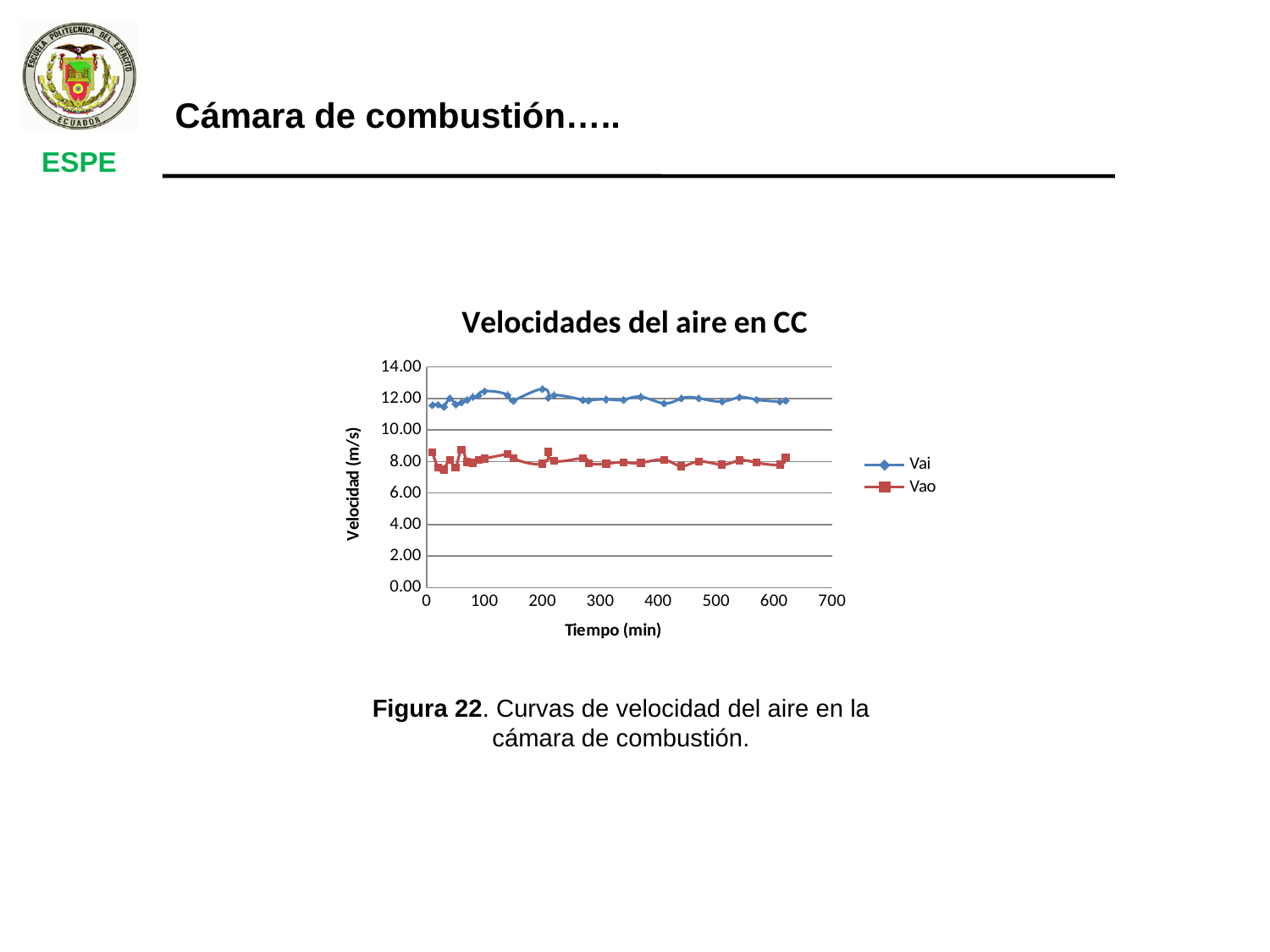
Which series has higher values throughout, Vai or Vao? Vai What is the title of the chart? Velocidades del aire en CC What is the label of the x axis? Tiempo (min) Are the values of the Vao series greater or less than 6.00? greater Are the values of the Vai series greater or less than 14.00? less What kind of chart is shown on the slide? line chart Are the values of the Vai series greater or less than 10.00? greater What are the names of the two series in the legend? Vai and Vao How many series does the legend list? 2